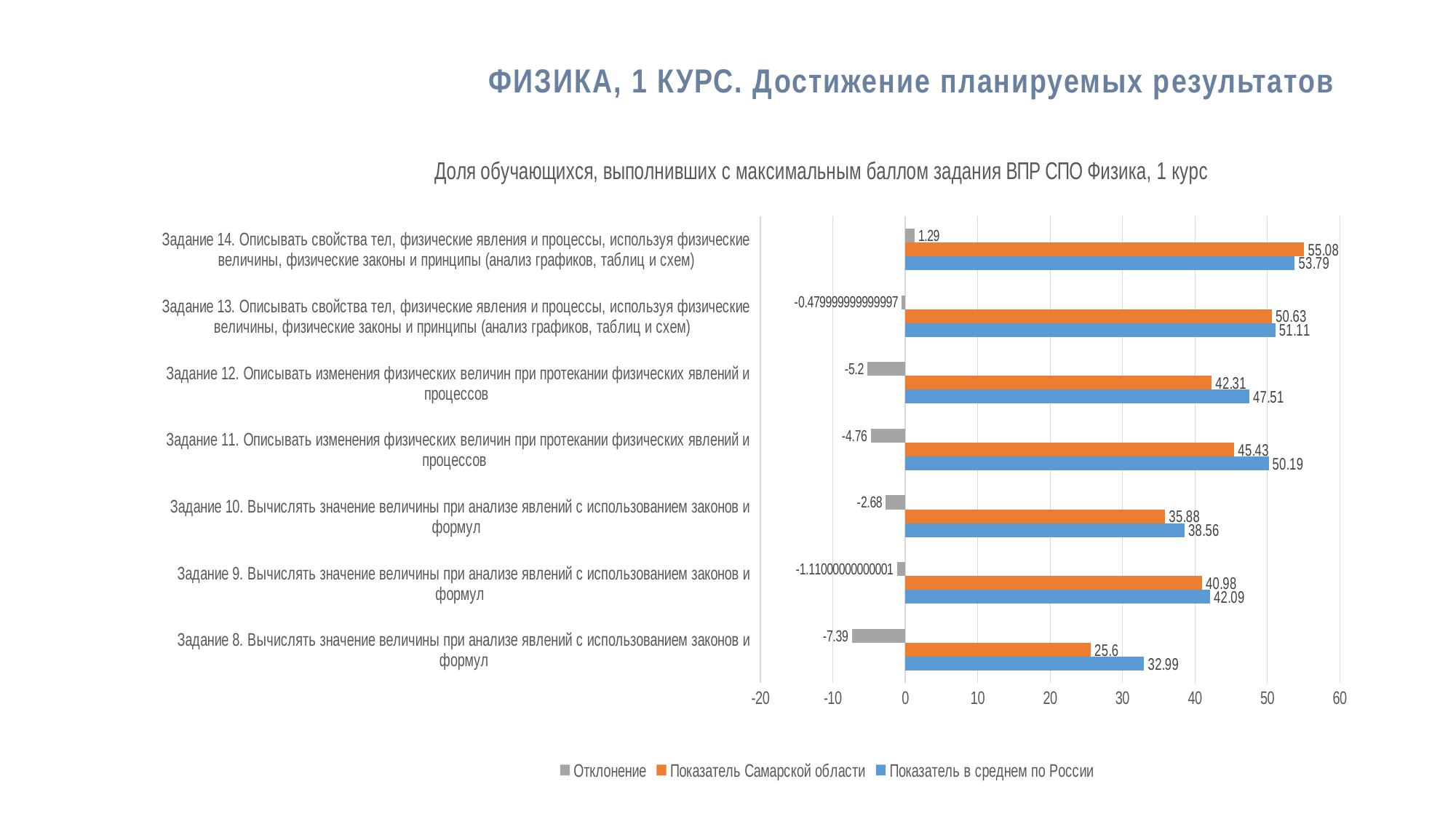
Which task has the highest value for Показатель в среднем по России? Задание 14 What is the difference between Показатель в среднем по России and Показатель Самарской области for Задание 11? 4.76 What type of chart is shown on the slide? bar chart How many series does the legend list? 3 For Задание 14, which is larger: Показатель Самарской области or Показатель в среднем по России? Показатель Самарской области Which task has the lowest (most negative) Отклонение value? Задание 8 Which task has the lowest value for Показатель Самарской области? Задание 8 What is the Отклонение value for Задание 12? -5.2 Which series is shown in orange in the legend? Показатель Самарской области What is the value of Показатель в среднем по России for Задание 8? 32.99 What is the value of Показатель Самарской области for Задание 14? 55.08 How many tasks (categories) are plotted on the chart? 7